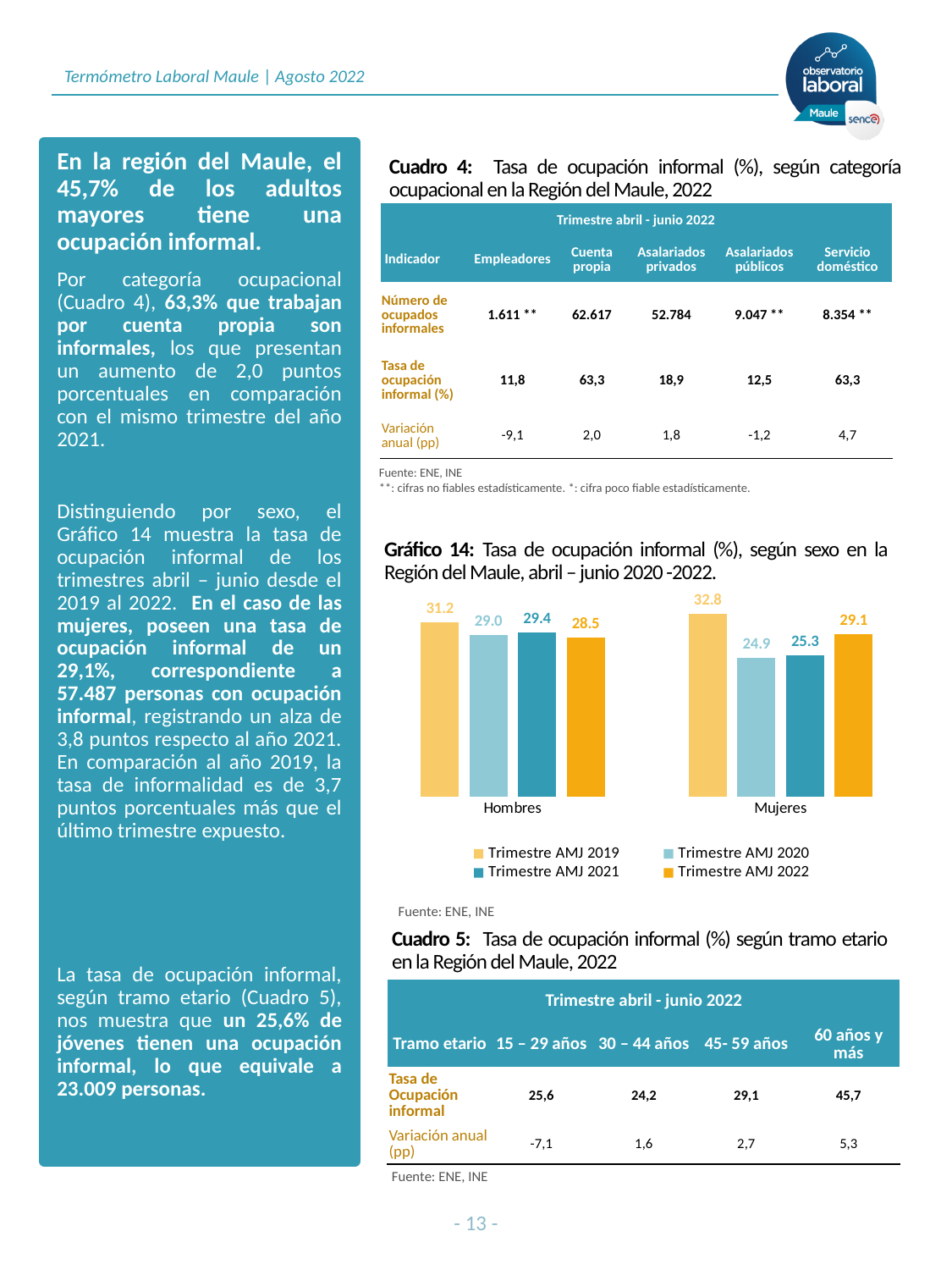
In Gráfico 14, what is the difference between the Mujeres values for Trimestre AMJ 2019 and Trimestre AMJ 2020? 7.9 In Gráfico 14, what is the value for Mujeres in Trimestre AMJ 2020? 24.9 In Gráfico 14, which series has the highest value for Mujeres? Trimestre AMJ 2019 In Gráfico 14, what is the value for Hombres in Trimestre AMJ 2021? 29.4 In Gráfico 14, what is the value for Mujeres in Trimestre AMJ 2022? 29.1 In Gráfico 14, which is larger for Trimestre AMJ 2022: Hombres or Mujeres? Mujeres In Gráfico 14, how many categories are shown on the x axis? 2 In Gráfico 14, what is the value for Hombres in Trimestre AMJ 2019? 31.2 In Gráfico 14, which series has the lowest value for Hombres? Trimestre AMJ 2022 In Gráfico 14, how many series does the legend list? 4 What kind of chart is Gráfico 14? Bar chart In Gráfico 14, what colour are the bars for Trimestre AMJ 2022? Orange